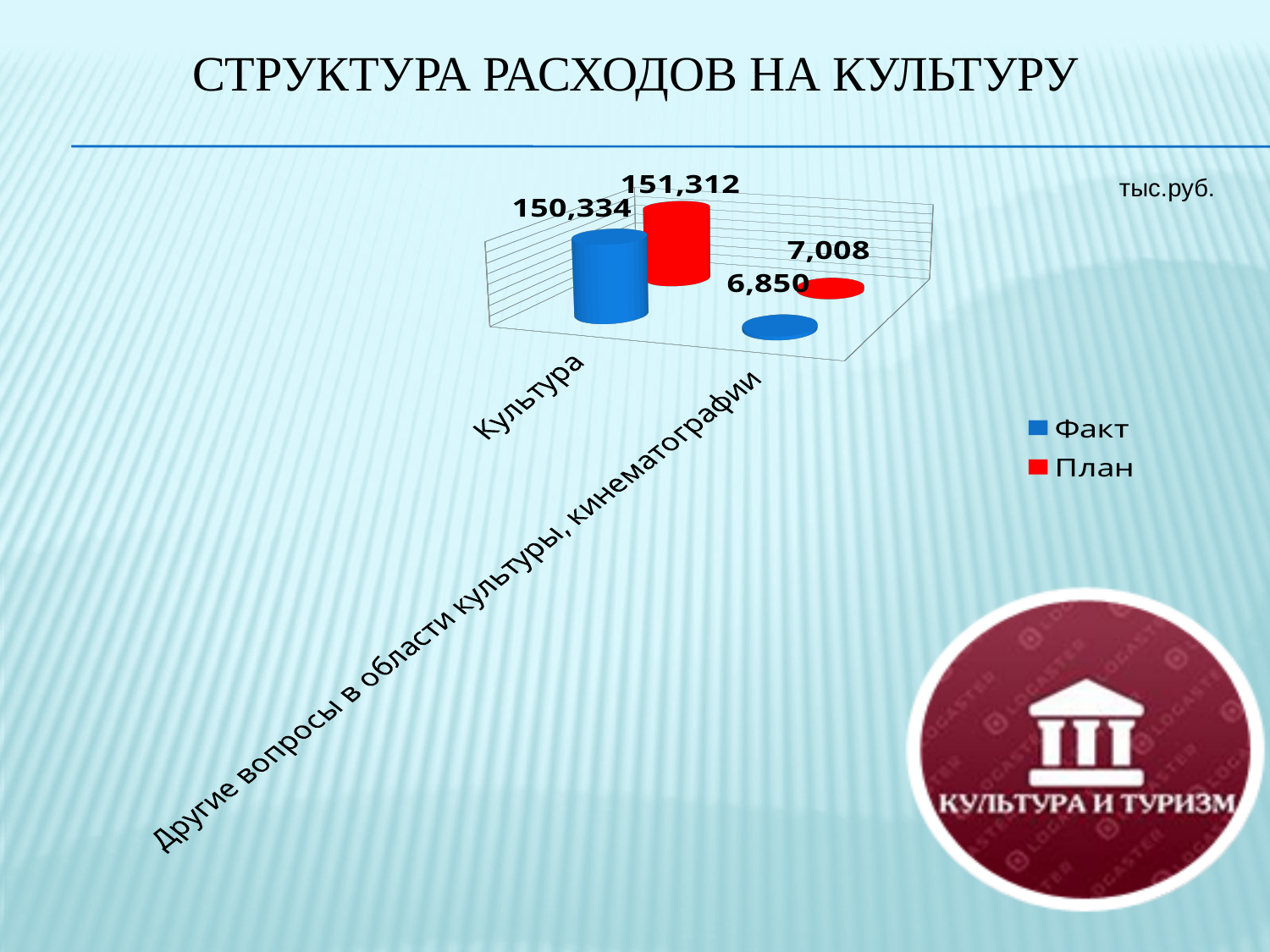
What is the Факт value for Культура? 150,334 How many series does the legend list? 2 What is the difference between the План and Факт values for Культура? 978 What is the План value for Другие вопросы в области культуры, кинематографии? 7,008 What is the difference between the План and Факт values for Другие вопросы в области культуры, кинематографии? 158 What unit is stated for the chart values? тыс.руб. Which is larger for Культура, the Факт value or the План value? План Which category has the highest План value? Культура How many categories are shown on the chart? 2 Which category has the lowest Факт value? Другие вопросы в области культуры, кинематографии What is the Факт value for Другие вопросы в области культуры, кинематографии? 6,850 What is the План value for Культура? 151,312